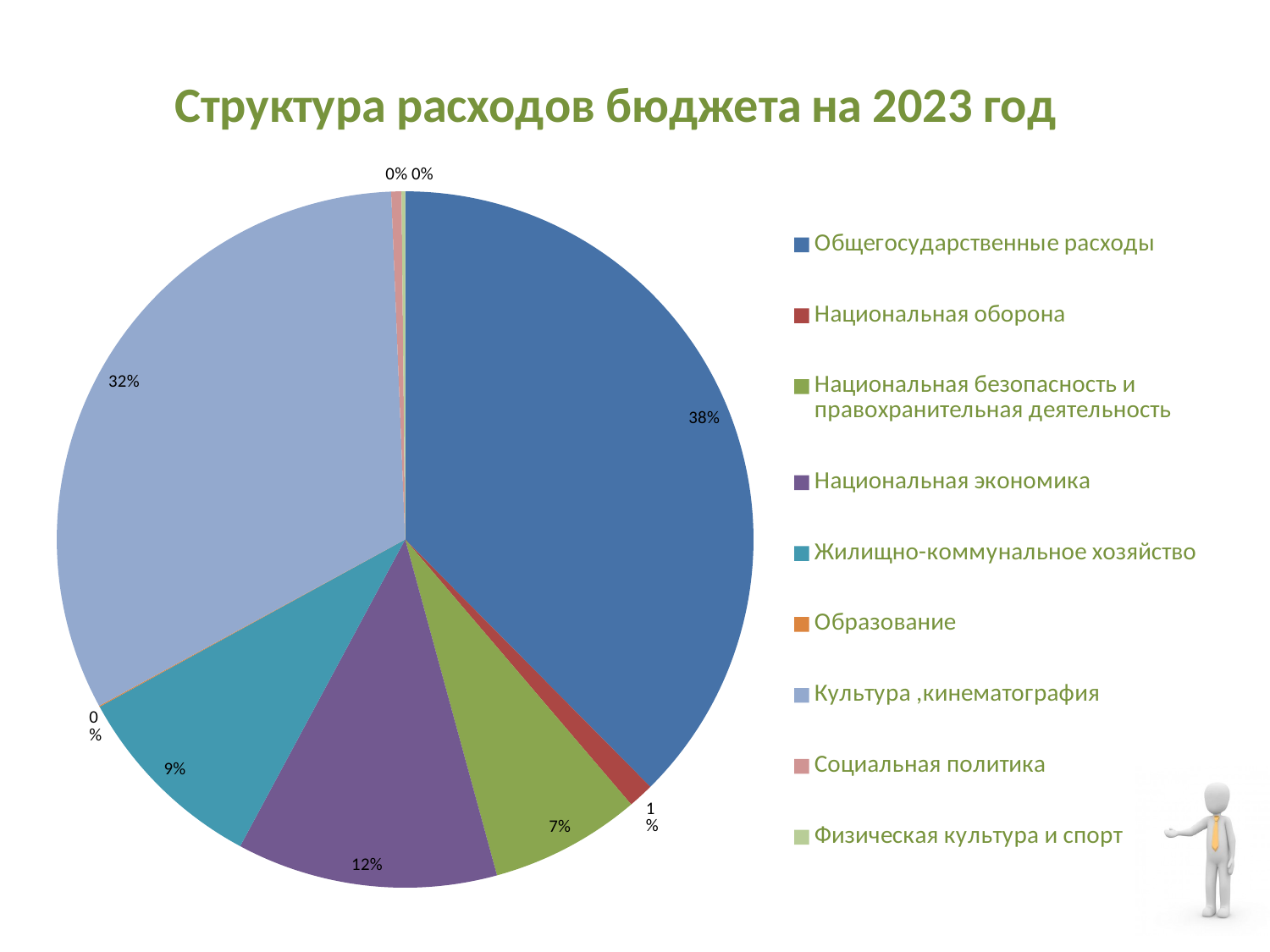
What share of the pie is Национальная безопасность и правохранительная деятельность? 7% What share of the pie is Национальная оборона? 1% Which category has the largest share of the pie? Общегосударственные расходы What share of the pie is Культура ,кинематография? 32% What is the title of the chart? Структура расходов бюджета на 2023 год How many categories does the legend list? 9 Which is larger, the share for Национальная экономика or the share for Жилищно-коммунальное хозяйство? Национальная экономика What kind of chart is shown on the slide? pie chart What is the difference between the share for Общегосударственные расходы and the share for Культура ,кинематография? 6%